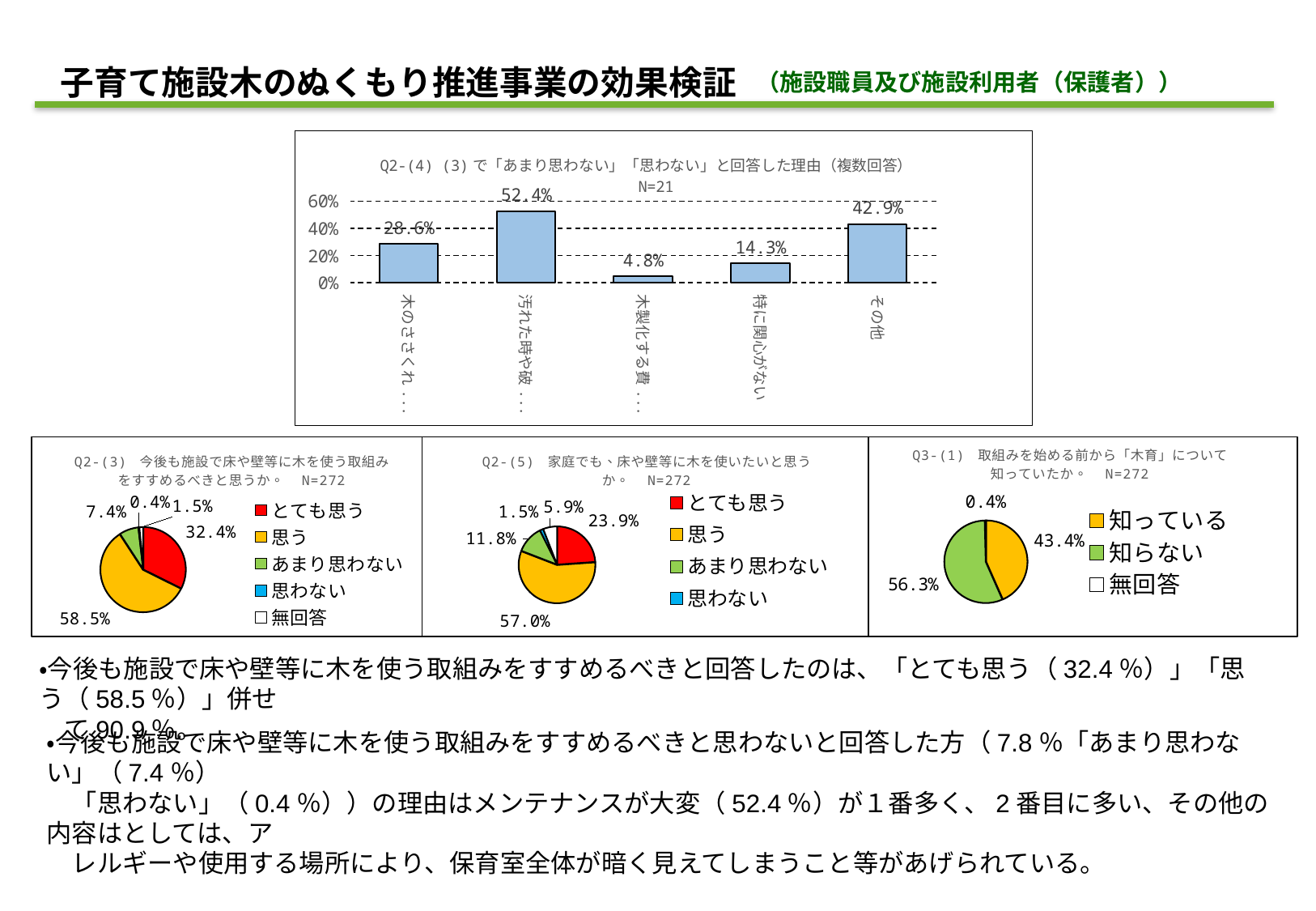
In the top bar chart (Q2-(4)), what is the lowest value shown? 4.8% In the bottom-left pie chart (Q2-(3)), which category has the smallest share? 思わない In the top bar chart (Q2-(4)), what is the highest value shown? 52.4% How many entries does the legend of the bottom-right pie chart (Q3-(1)) list? 3 In the bottom-right pie chart (Q3-(1)), which is larger, 知っている or 知らない? 知らない In the top bar chart (Q2-(4)), what is the value for その他? 42.9% In the top bar chart (Q2-(4)), what is the value for 特に関心がない? 14.3% In the bottom-middle pie chart (Q2-(5)), what share is とても思う? 23.9% What kind of chart is the top chart (Q2-(4))? Bar chart In the top bar chart (Q2-(4)), what is the difference between the values for その他 and 特に関心がない? 28.6% In the top bar chart (Q2-(4)), how many bars are plotted? 5 In the bottom-left pie chart (Q2-(3)), what share is 思う? 58.5%